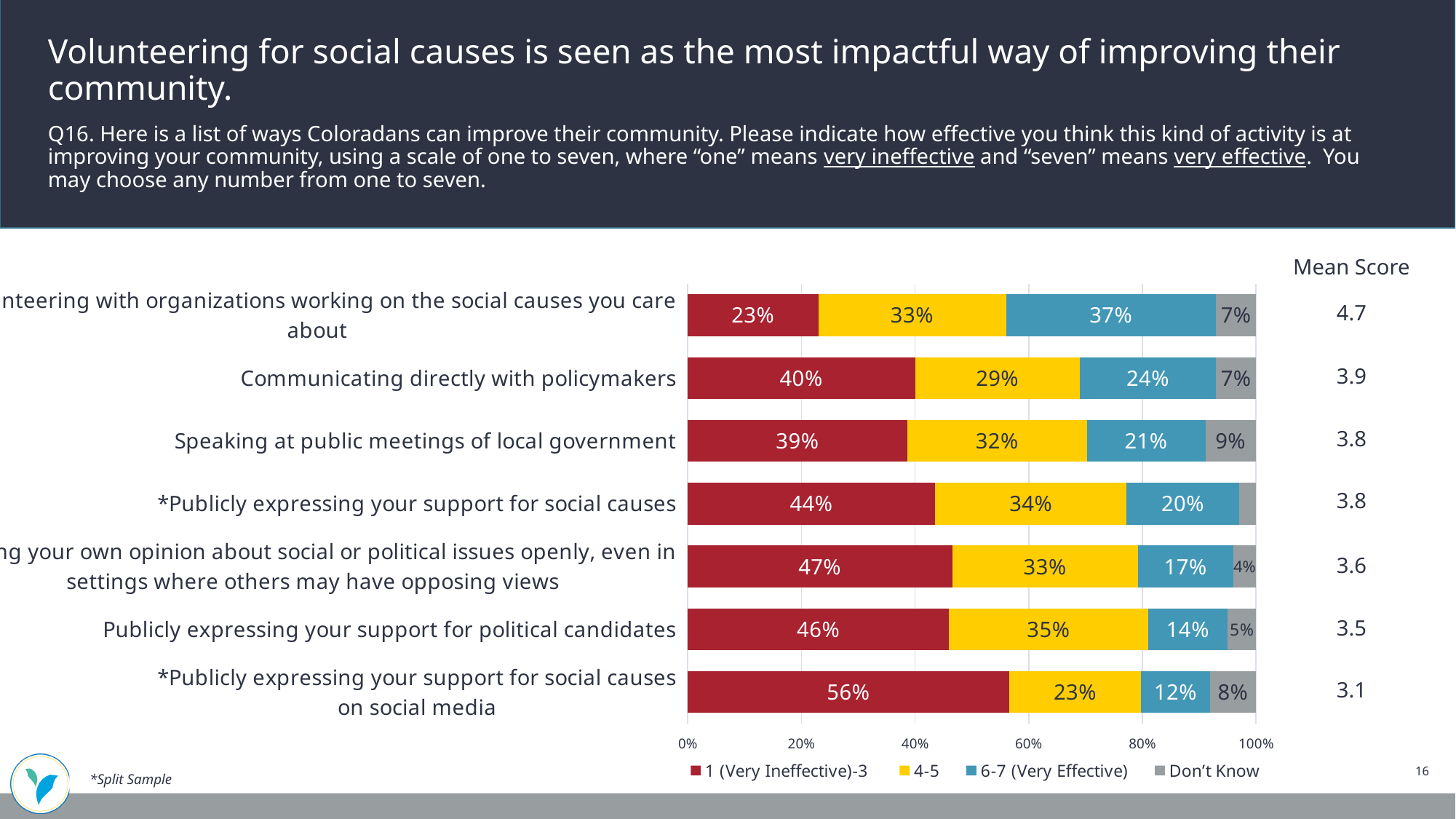
What percentage rated "Publicly expressing your support for social causes on social media" as 6-7 (Very Effective)? 12% How many series does the legend list? 4 For "Communicating directly with policymakers", how many percentage points larger is the 1 (Very Ineffective)-3 share than the 6-7 (Very Effective) share? 16 percentage points What percentage rated "Communicating directly with policymakers" as 1 (Very Ineffective)-3? 40% What kind of chart is shown on the slide? Stacked bar chart How many activities (bars) are shown in the chart? 7 What colour represents the 4-5 rating series in the chart? Yellow Which activity has the lowest share of 6-7 (Very Effective) ratings? Publicly expressing your support for social causes on social media Which has a larger 4-5 share: "Publicly expressing your support for political candidates" or "Speaking at public meetings of local government"? Publicly expressing your support for political candidates Which activity has the highest share of 1 (Very Ineffective)-3 ratings? Publicly expressing your support for social causes on social media What is the "Don't Know" percentage for "Publicly expressing your support for political candidates"? 5% What is the "Don't Know" percentage for "Speaking at public meetings of local government"? 9%